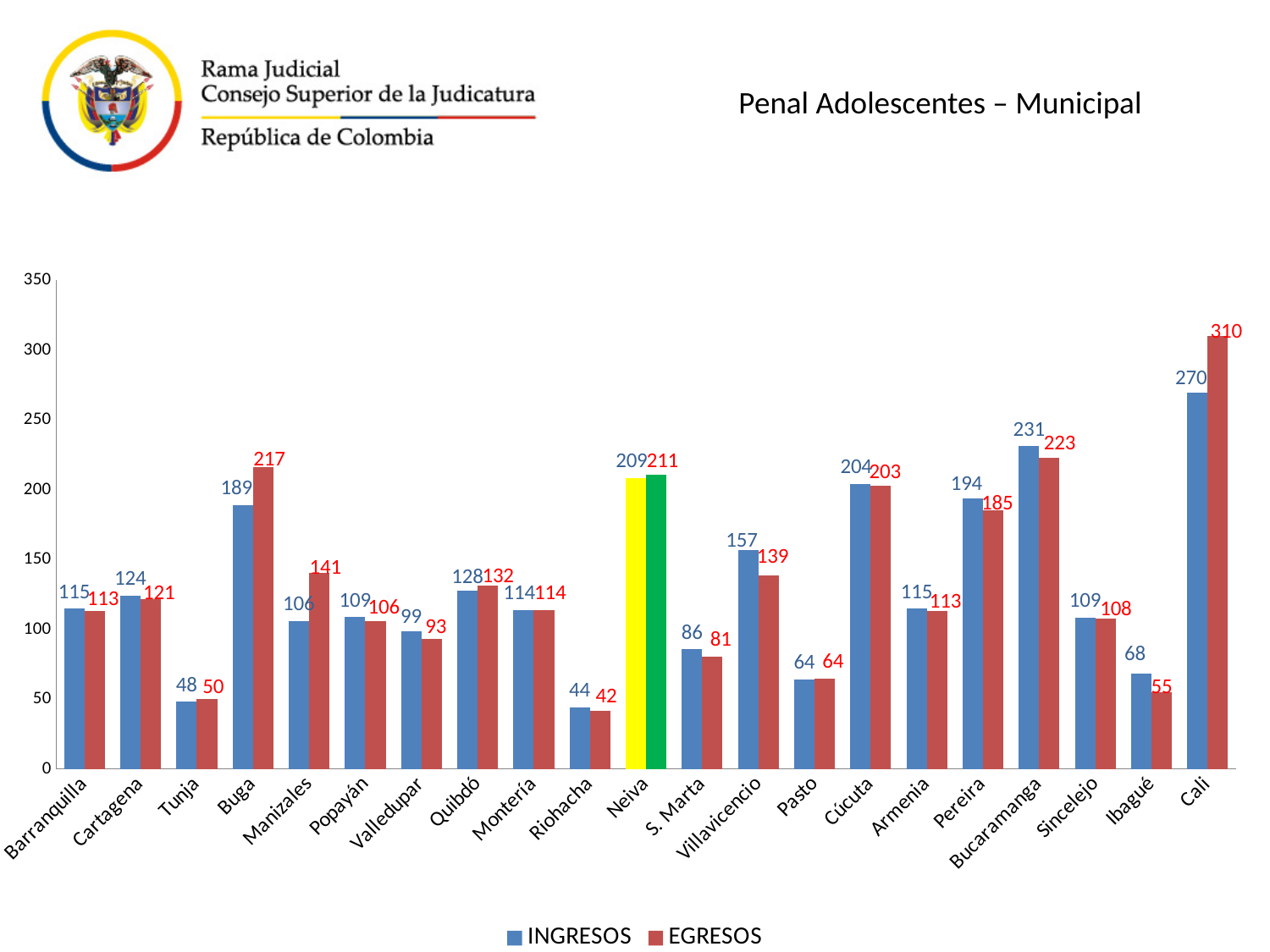
What is the EGRESOS value for Buga? 217 Which city has the lowest INGRESOS value? Riohacha What is the INGRESOS value for Bucaramanga? 231 What kind of chart is shown on the slide? Bar chart What is the difference between EGRESOS and INGRESOS for Manizales? 35 Which city has the highest EGRESOS value? Cali What is the INGRESOS value for Neiva? 209 Which is larger for Villavicencio, INGRESOS or EGRESOS? INGRESOS How many series does the legend list? 2 How many cities are shown on the x axis? 21 Which city's bars are highlighted in yellow and green instead of the standard colours? Neiva What is the difference between EGRESOS and INGRESOS for Cali? 40